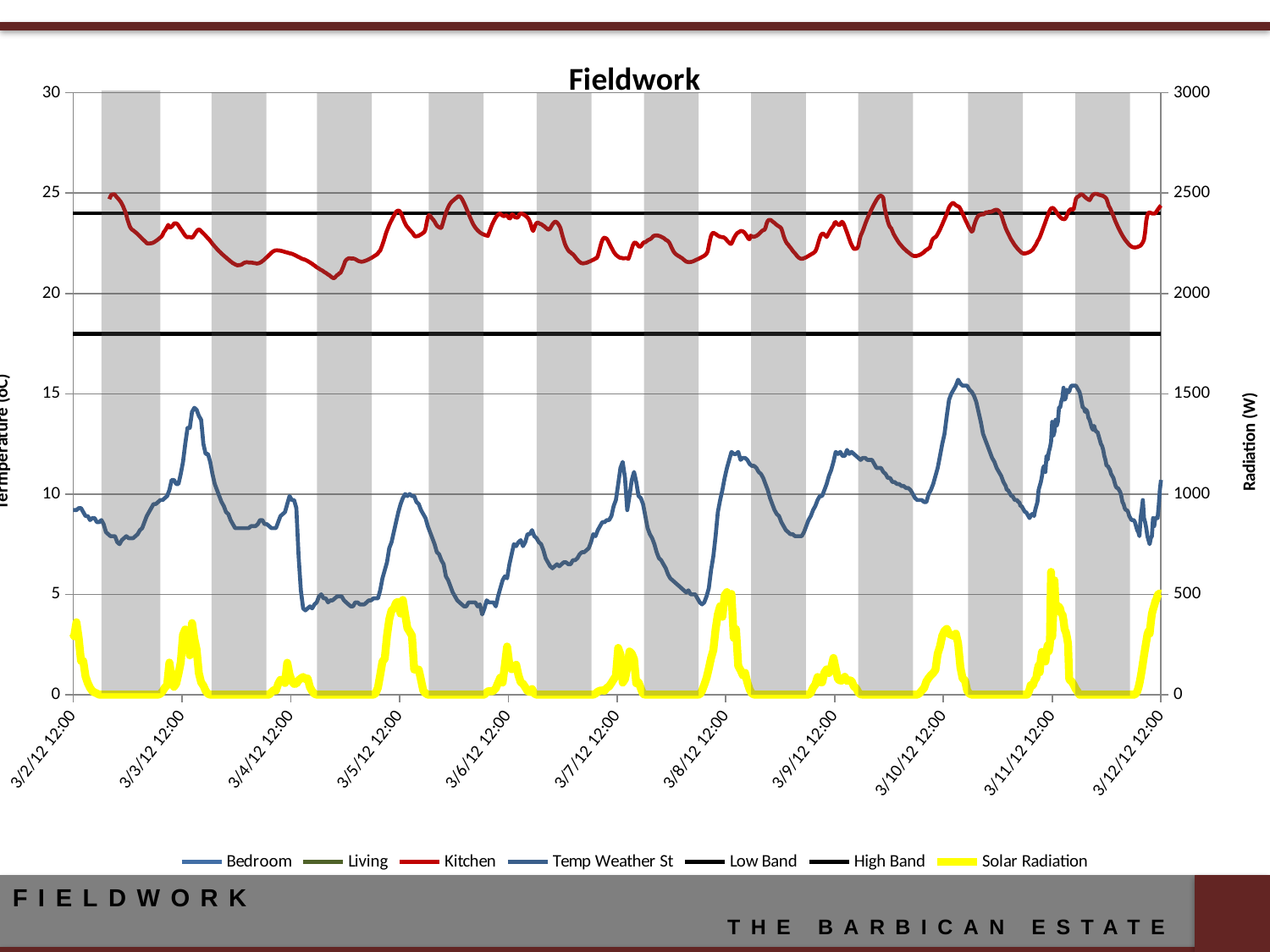
What is the first date label on the x axis? 3/2/12 12:00 What kind of chart is shown on the slide? line chart What is the title of the chart? Fieldwork What colour is used for the Solar Radiation series? yellow How many series does the legend list? 7 Is the High Band line greater or less than 20 on the temperature axis? greater How many date labels are shown along the x axis? 11 Is the Kitchen value at 3/2/12 12:00 greater or less than 20? greater What is the maximum value shown on the right-hand Radiation (W) axis? 3000 Is the Low Band line greater or less than 20 on the temperature axis? less What is the last date label on the x axis? 3/12/12 12:00 Which series is plotted higher on the chart throughout, Kitchen or Temp Weather St? Kitchen